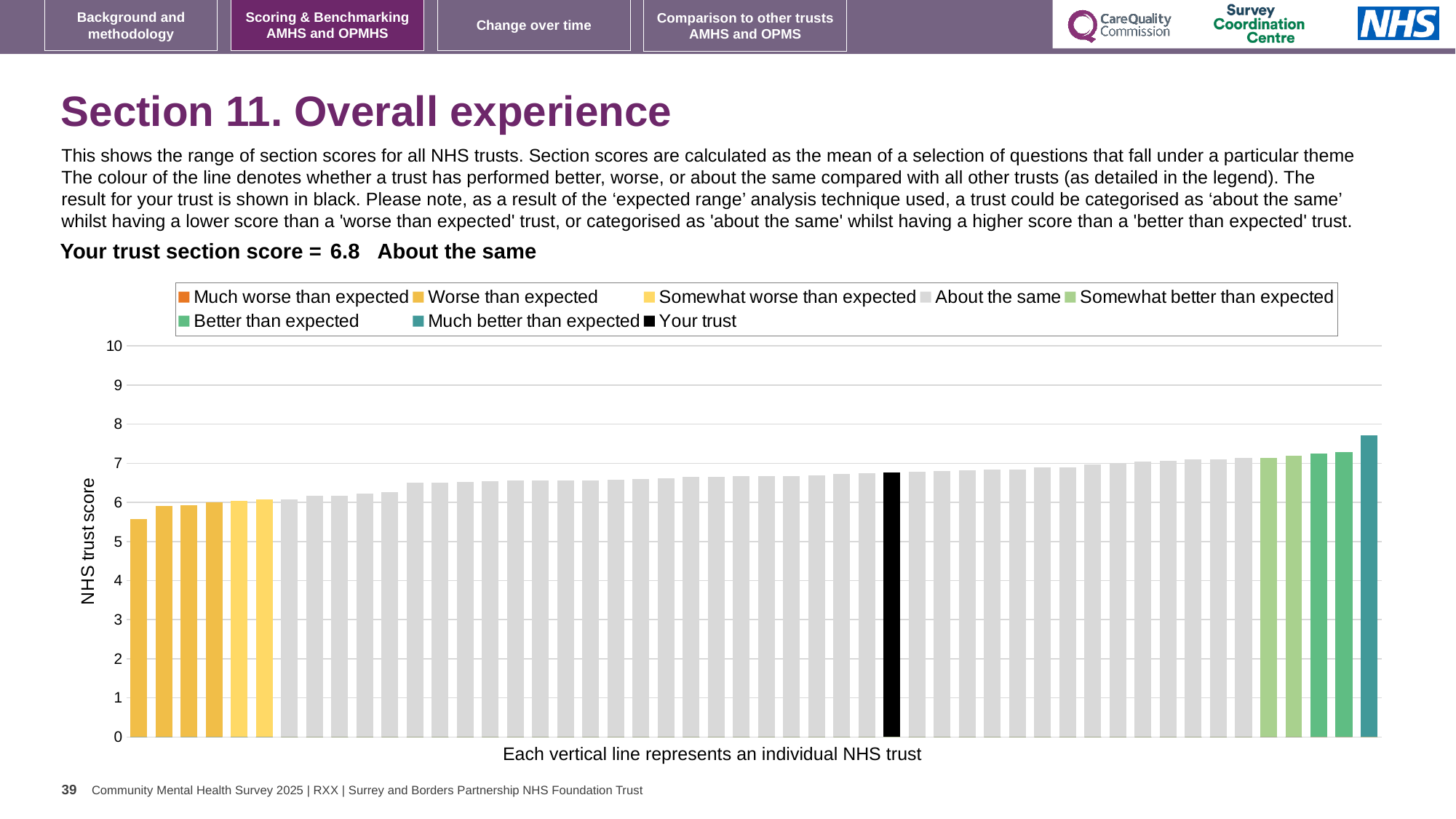
Is the value for the highest bar on the chart greater or less than 7? greater What is the section score for your trust shown on the slide? 6.8 Which category is your trust's section score placed in? About the same What kind of chart is shown on the slide? bar chart Is the value for the lowest bar on the chart greater or less than 6? less Do the bar values rise or fall from left to right along the x axis? rise How many entries does the chart legend list? 8 Is the value for your trust (the black bar) greater or less than 6? greater What is the label on the vertical axis of the chart? NHS trust score What colour is used in the legend for 'Your trust'? black